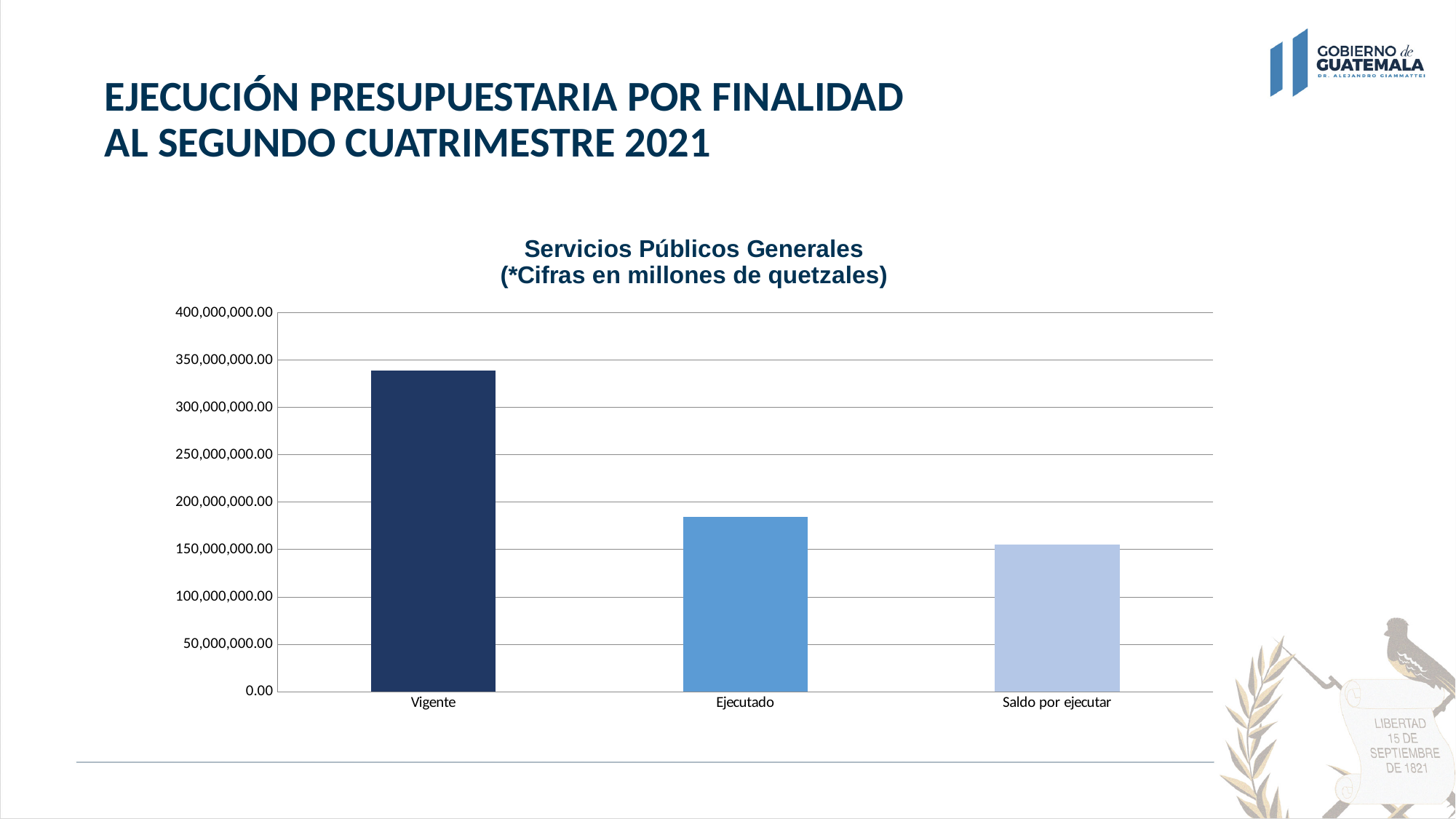
How many categories are shown on the x axis of the chart? 3 Do the bar values rise or fall from left to right across the x axis? Fall Is the value for Vigente greater or less than 300,000,000.00? greater Is the value for Saldo por ejecutar greater or less than 200,000,000.00? less Which category has the highest value in the chart? Vigente Which is larger, the value for Vigente or the value for Ejecutado? Vigente Which is larger, the value for Ejecutado or the value for Saldo por ejecutar? Ejecutado What kind of chart is shown on the slide? Bar chart Which category has the lowest value in the chart? Saldo por ejecutar Is the value for Ejecutado greater or less than 200,000,000.00? less What is the title of the chart? Servicios Públicos Generales (*Cifras en millones de quetzales)